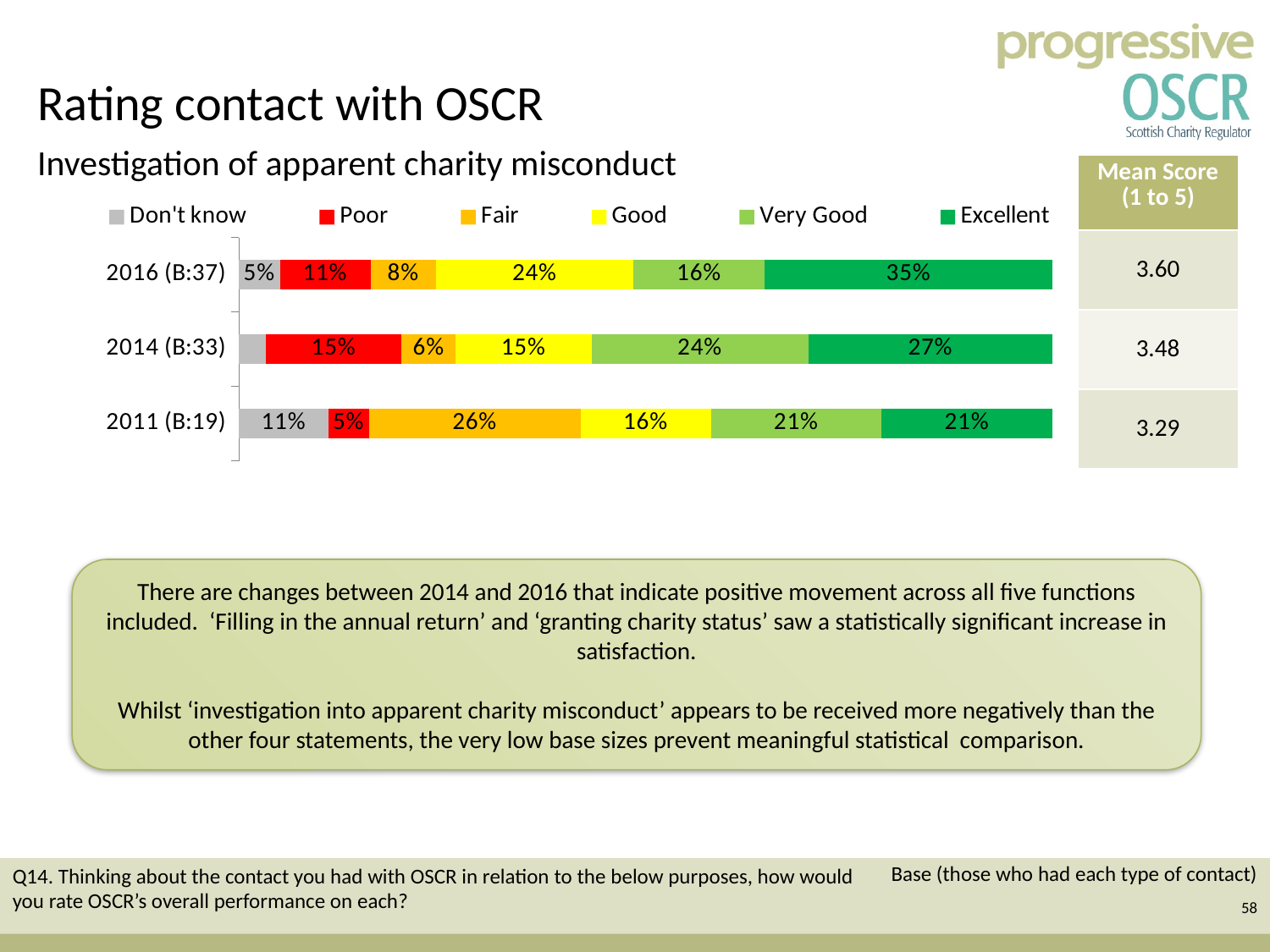
What is the Poor value for 2014 (B:33)? 15% What percentage rated contact as Excellent in 2016 (B:37)? 35% By how many percentage points did the Excellent rating increase from 2014 (B:33) to 2016 (B:37)? 8 percentage points How many years (bars) are shown in the chart? 3 What percentage rated contact as Fair in 2011 (B:19)? 26% Which year has the lowest Poor percentage? 2011 (B:19) What type of chart is used on this slide? Stacked bar chart How many rating categories does the legend list? 6 Which year has the highest Excellent percentage? 2016 (B:37) Which rating category is shown in red in the legend? Poor What is the total of all segments in the 2011 (B:19) bar? 100% Which year has the larger Very Good percentage, 2014 (B:33) or 2016 (B:37)? 2014 (B:33)